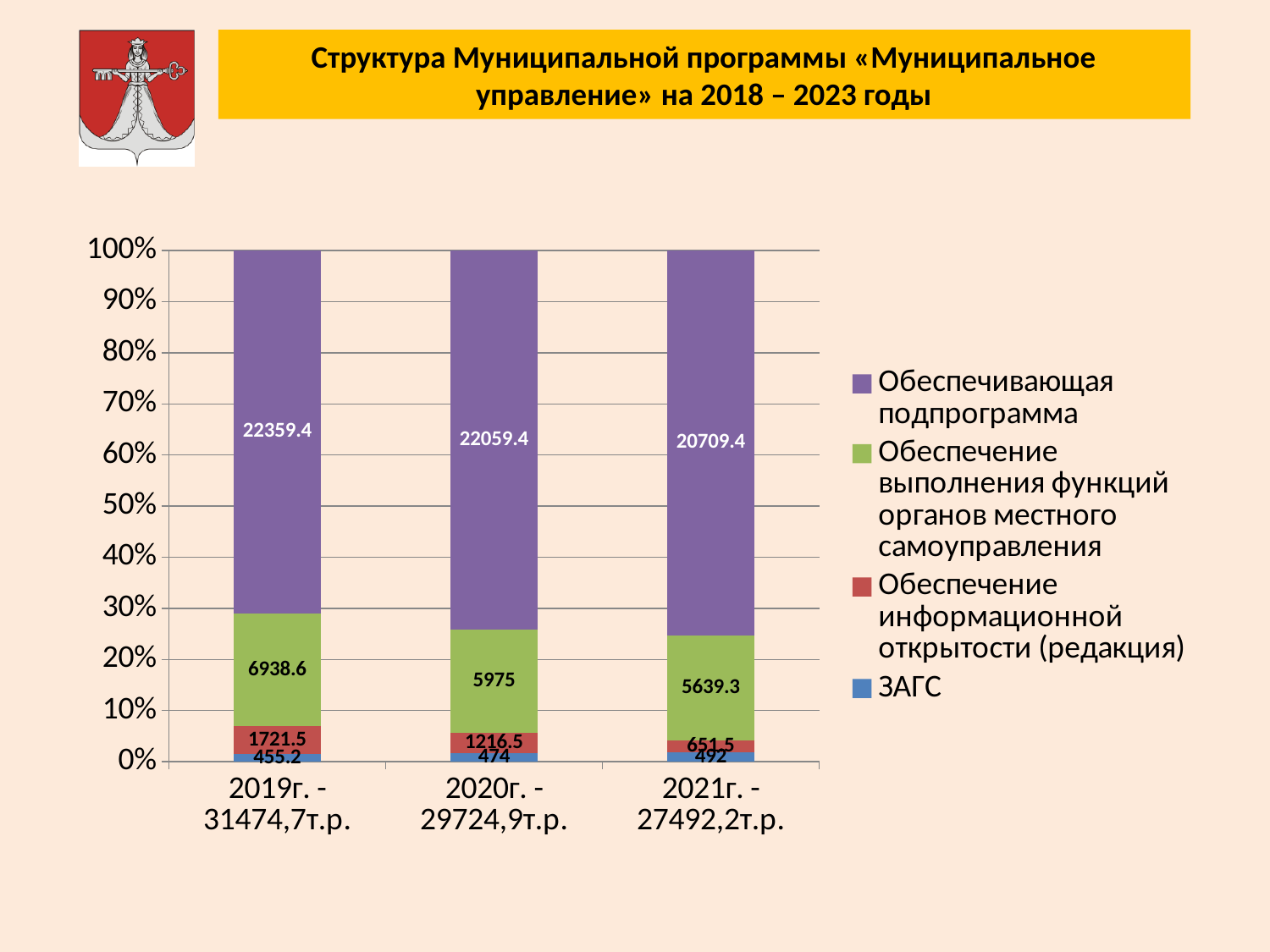
What is the difference between the Обеспечивающая подпрограмма values for 2019г. and 2021г.? 1650 How many years (bars) are shown on the chart? 3 Does the value of Обеспечивающая подпрограмма rise or fall from 2019г. to 2021г.? Fall What is the value of Обеспечение информационной открытости (редакция) for 2020г.? 1216.5 What kind of chart is shown on the slide? Stacked bar chart Which is larger: the ЗАГС value for 2019г. or for 2020г.? 2020г. What is the total for the 2020г. bar as shown in its axis label? 29724,9т.р. What is the value of Обеспечивающая подпрограмма for 2019г.? 22359.4 What is the value of ЗАГС for 2021г.? 492 In which year is the value of Обеспечение выполнения функций органов местного самоуправления highest? 2019г. In which year is the value of Обеспечение информационной открытости (редакция) lowest? 2021г. How many series does the legend list? 4